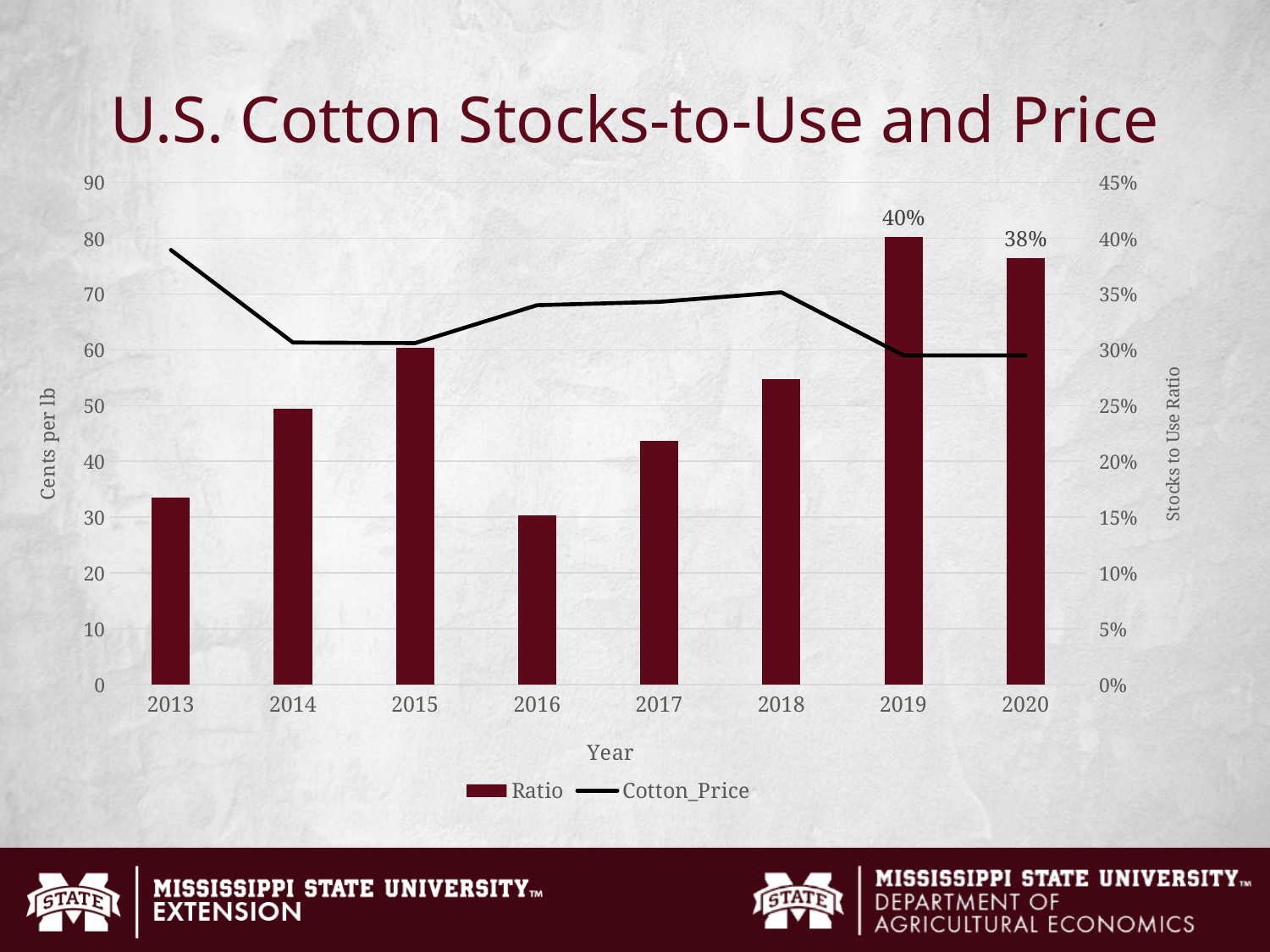
What kind of chart is this? Combination bar and line chart Which year has the larger Ratio bar, 2014 or 2015? 2015 Which year has the highest stocks-to-use ratio bar? 2019 What is the stocks-to-use ratio shown for 2019? 40% How many years are shown on the x axis? 8 How many series does the legend list? 2 What is the stocks-to-use ratio shown for 2020? 38% Is the Cotton_Price value for 2013 greater or less than 70 cents per lb? greater Is the Ratio value for 2016 greater or less than 20%? less Which year has the highest cotton price on the line? 2013 Does the Cotton_Price line rise or fall from 2018 to 2019? Fall By how many percentage points does the 2019 ratio exceed the 2020 ratio? 2 percentage points